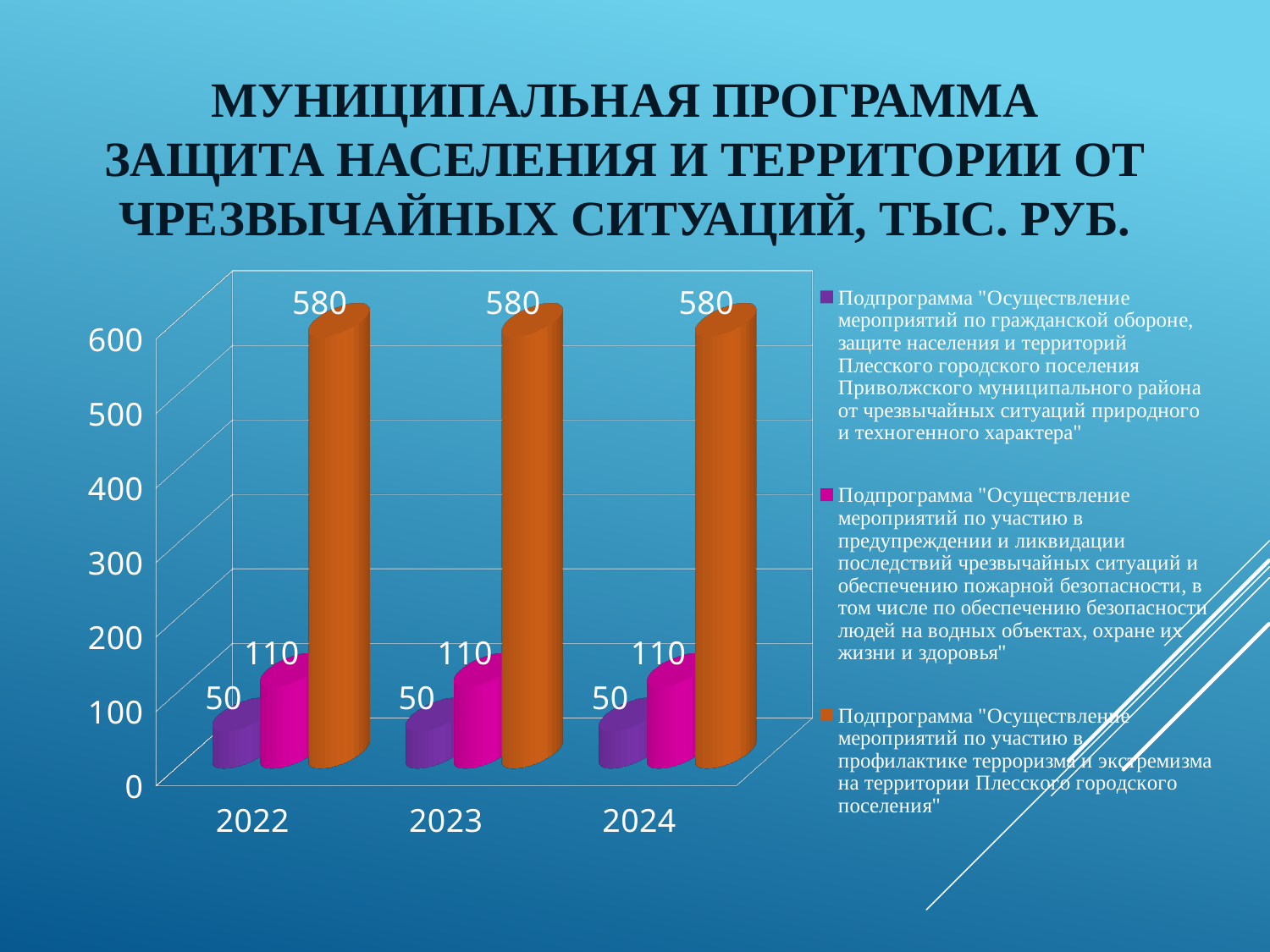
Do the values for the orange series rise, fall or stay the same from 2022 to 2024? stay the same What is the value for 2022 for the subprogram on preventing terrorism and extremism (orange bars)? 580 In 2022, which is larger: the value for the civil defence subprogram (purple) or the emergency prevention and fire safety subprogram (magenta)? the emergency prevention and fire safety subprogram (magenta), 110 What is the difference between the orange bar (580) and the magenta bar (110) in 2023? 470 Which subprogram has the highest value in 2024? Подпрограмма "Осуществление мероприятий по участию в профилактике терроризма и экстремизма на территории Плесского городского поселения" How many series does the chart legend list? 3 What kind of chart is shown on the slide? bar chart What unit of measurement is stated in the chart title? тыс. руб. How many years are shown on the x axis of the chart? 3 What is the value for 2023 for the subprogram on civil defence and protection from emergencies (purple bars)? 50 What is the value for 2024 for the subprogram on emergency prevention and fire safety (magenta bars)? 110